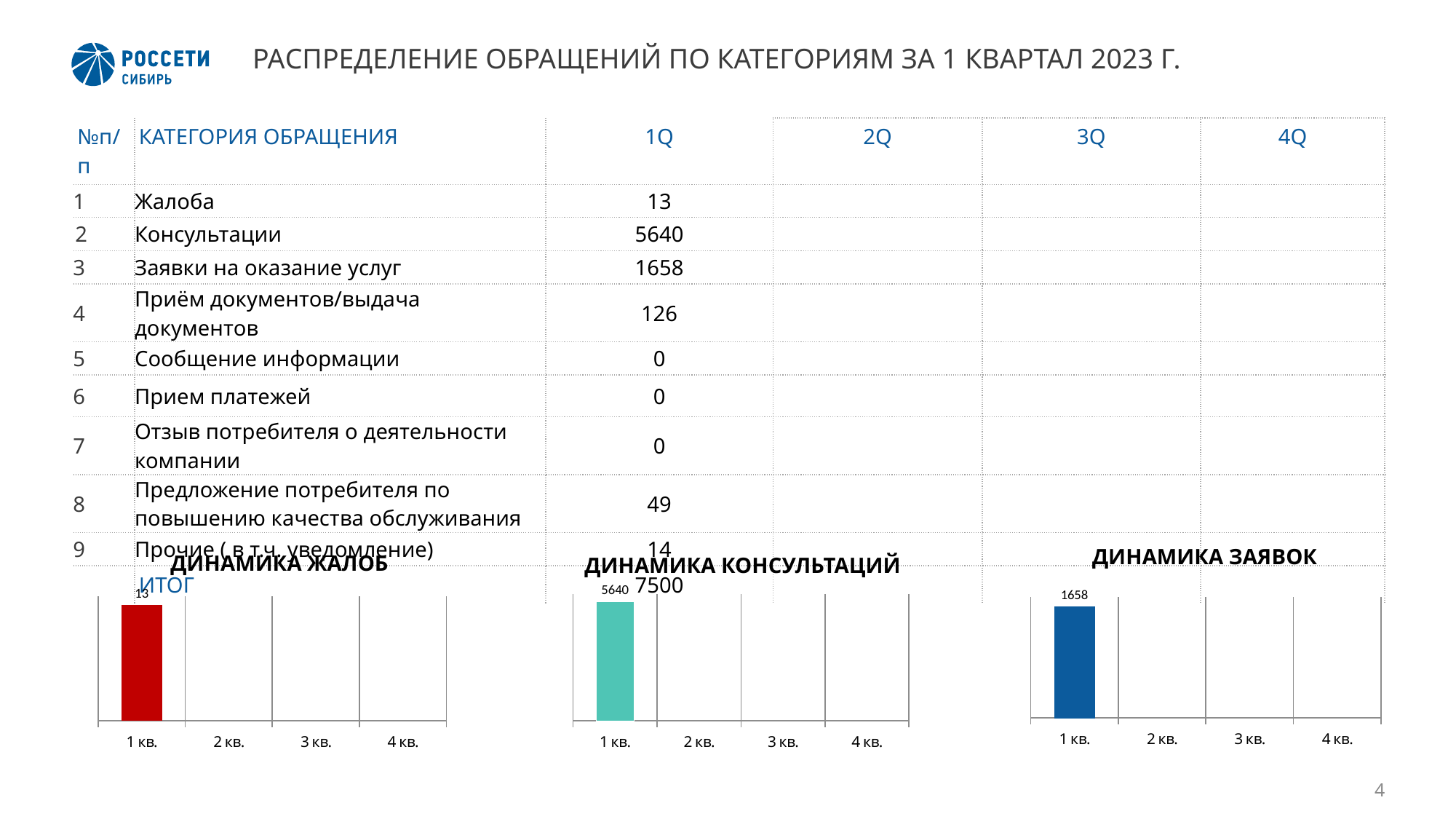
How many categories are shown on the x axis of the chart titled ДИНАМИКА ЗАЯВОК? 4 What is the difference between the 1 кв. value in the chart titled ДИНАМИКА КОНСУЛЬТАЦИЙ and the 1 кв. value in the chart titled ДИНАМИКА ЗАЯВОК? 3982 In the chart titled ДИНАМИКА КОНСУЛЬТАЦИЙ, what is the value for 1 кв.? 5640 In the chart titled ДИНАМИКА ЖАЛОБ, what is the value for 1 кв.? 13 In the chart titled ДИНАМИКА КОНСУЛЬТАЦИЙ, which category has the highest value? 1 кв. What is the title of the chart on the right side of the slide? ДИНАМИКА ЗАЯВОК In the chart titled ДИНАМИКА ЗАЯВОК, what is the value for 1 кв.? 1658 What colour is the bar in the chart titled ДИНАМИКА ЖАЛОБ? red What is the difference between the 1 кв. value in the chart titled ДИНАМИКА ЗАЯВОК and the 1 кв. value in the chart titled ДИНАМИКА ЖАЛОБ? 1645 What kind of chart is the chart titled ДИНАМИКА ЖАЛОБ? bar chart How many charts are shown on the slide? 3 Which is larger: the 1 кв. value in the chart titled ДИНАМИКА КОНСУЛЬТАЦИЙ or the 1 кв. value in the chart titled ДИНАМИКА ЗАЯВОК? ДИНАМИКА КОНСУЛЬТАЦИЙ